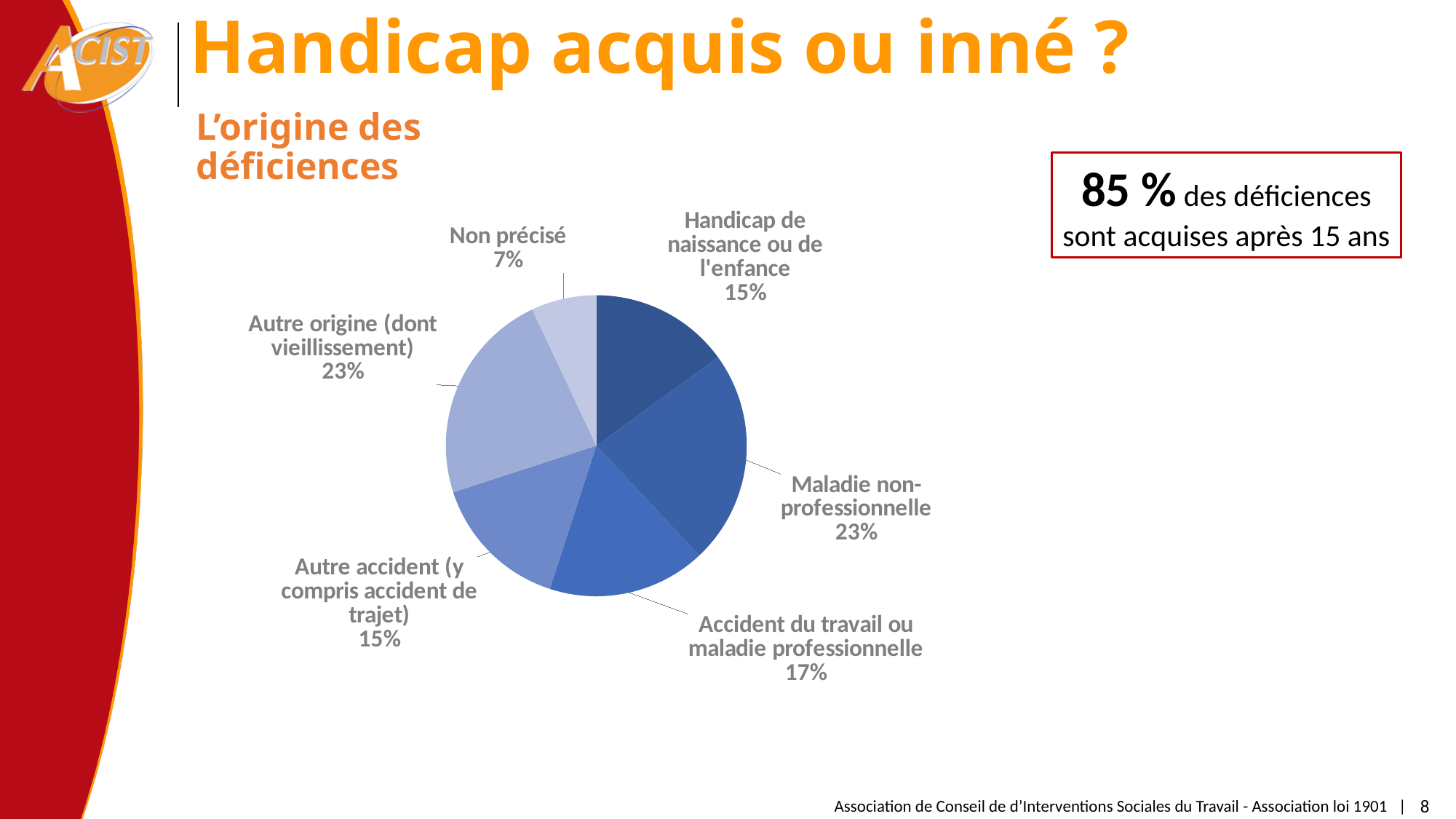
What kind of chart is shown on the slide? Pie chart What share of the pie is 'Non précisé'? 7% What is the title of the chart? L'origine des déficiences What is the difference in percentage points between 'Maladie non-professionnelle' and 'Non précisé'? 16 What share of the pie is 'Handicap de naissance ou de l'enfance'? 15% What share of the pie is 'Maladie non-professionnelle'? 23% Which category has the smallest slice of the pie? Non précisé What is the difference in percentage points between 'Accident du travail ou maladie professionnelle' and 'Handicap de naissance ou de l'enfance'? 2 How many slices does the pie chart have? 6 Which is larger: 'Accident du travail ou maladie professionnelle' or 'Autre accident (y compris accident de trajet)'? Accident du travail ou maladie professionnelle